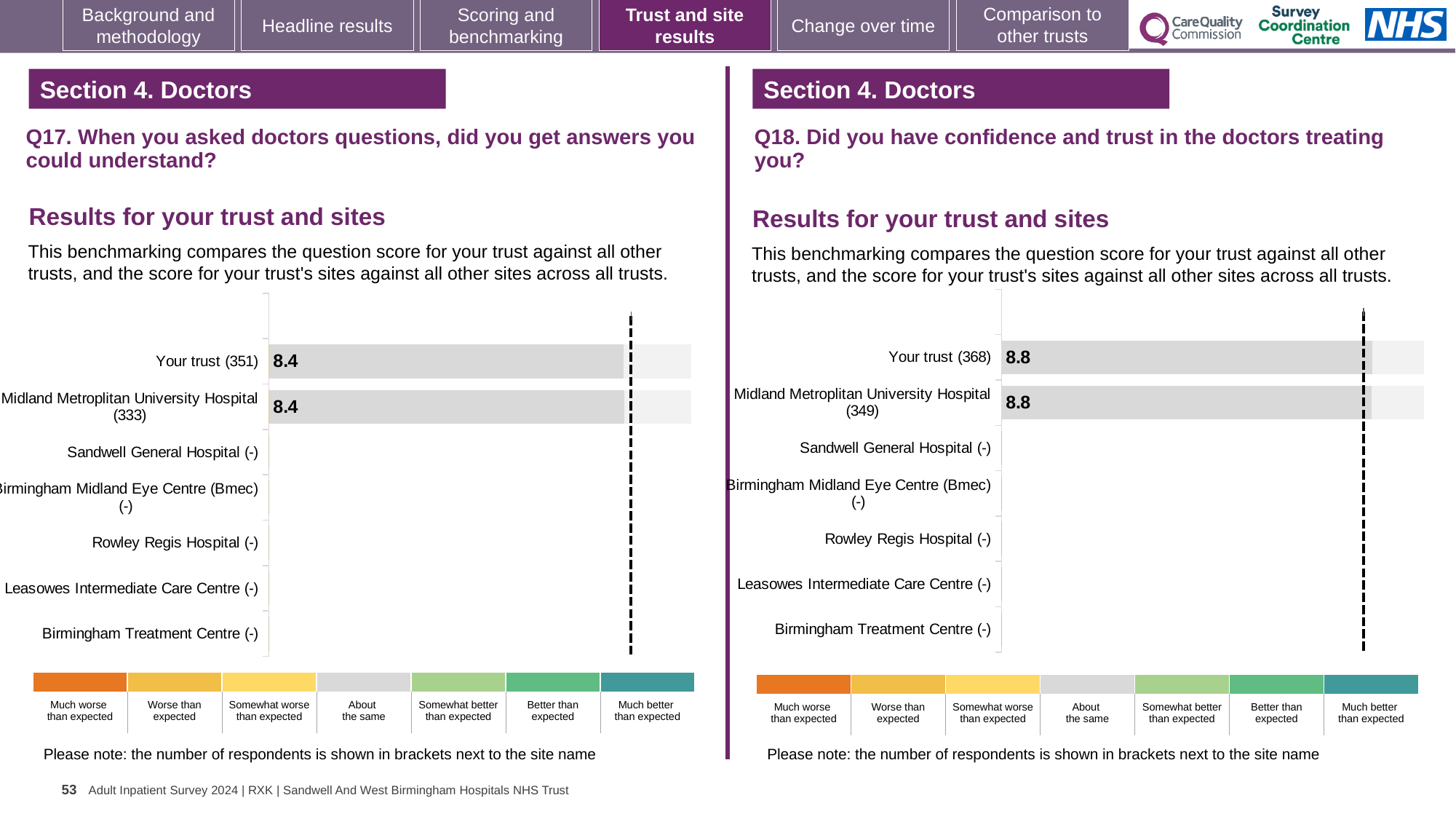
In the Q17 chart on the left, how many respondents are shown in brackets for Your trust? 351 What kind of chart is the Q18 chart on the right? Bar chart In the Q18 chart on the right, what is the score for Your trust (368)? 8.8 In the Q18 chart on the right, what is the difference between the score for Your trust and the score for Midland Metroplitan University Hospital? 0 In the Q17 chart on the left, what is the score for Midland Metroplitan University Hospital (333)? 8.4 In the Q17 chart on the left, what is the score for Your trust (351)? 8.4 In the Q17 chart on the left, what is the difference between the score for Your trust and the score for Midland Metroplitan University Hospital? 0 In the Q18 chart on the right, how many respondents are shown in brackets for Midland Metroplitan University Hospital? 349 How many site categories are listed on the y axis of the Q18 chart on the right? 7 How many benchmark categories does the colour key below the Q17 chart on the left list? 7 How many site categories are listed on the y axis of the Q17 chart on the left? 7 In the Q18 chart on the right, what is the score for Midland Metroplitan University Hospital (349)? 8.8